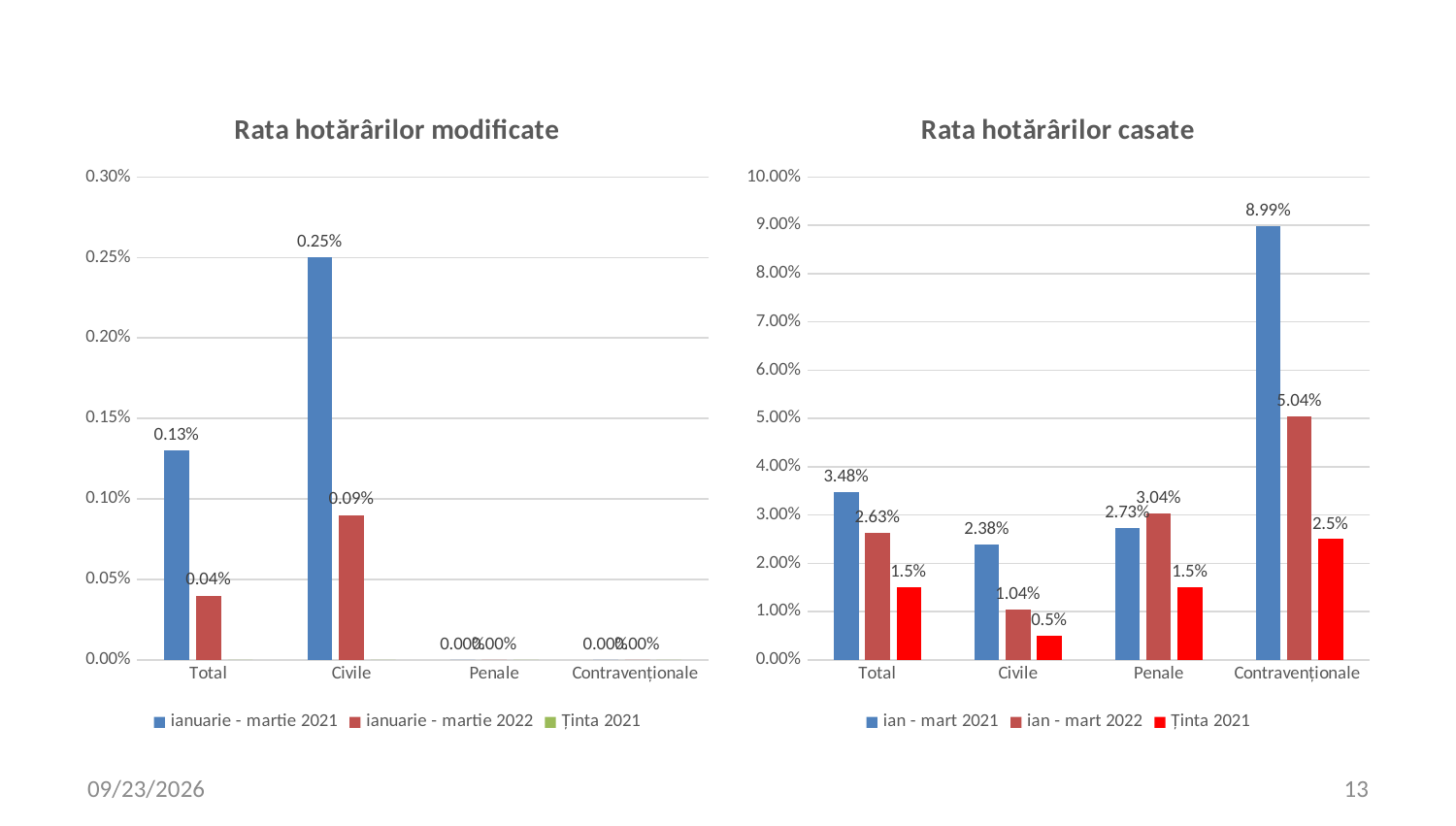
In the chart 'Rata hotărârilor modificate', how many series does the legend list? 3 In the chart 'Rata hotărârilor casate', how many categories are shown on the x axis? 4 In the chart 'Rata hotărârilor casate', which is larger for Penale: the 'ian - mart 2021' value or the 'ian - mart 2022' value? ian - mart 2022 In the chart 'Rata hotărârilor modificate', what is the value for Total in the series 'ianuarie - martie 2022'? 0.04% In the chart 'Rata hotărârilor modificate', what is the difference between the 'ianuarie - martie 2021' and 'ianuarie - martie 2022' values for Civile? 0.16% In the chart 'Rata hotărârilor casate', what is the 'Ținta 2021' value for Civile? 0.5% In the chart 'Rata hotărârilor casate', what is the value for Contravenționale in the series 'ian - mart 2021'? 8.99% In the chart 'Rata hotărârilor casate', which category has the lowest value in the series 'ian - mart 2022'? Civile In the chart 'Rata hotărârilor modificate', what is the value for Civile in the series 'ianuarie - martie 2021'? 0.25% What kind of chart is 'Rata hotărârilor casate'? Bar chart In the chart 'Rata hotărârilor casate', what is the difference between the 'ian - mart 2021' and 'ian - mart 2022' values for Contravenționale? 3.95% In the chart 'Rata hotărârilor modificate', which category has the highest value in the series 'ianuarie - martie 2021'? Civile